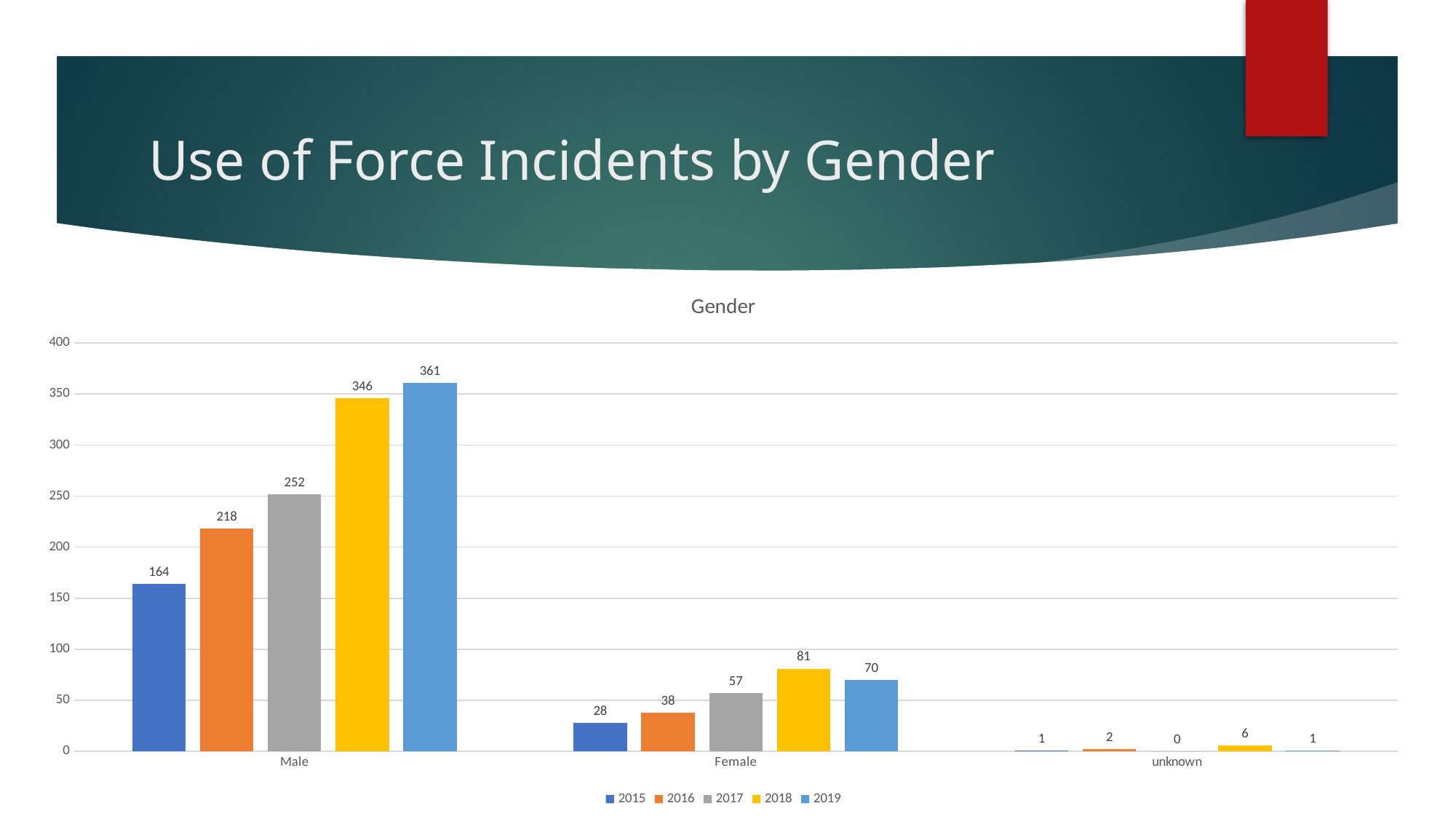
How many series does the legend list? 5 How many categories are shown on the x axis? 3 What is the value for Male in 2019? 361 What is the value for unknown in 2018? 6 Which is larger, the Female value for 2018 or for 2019? 2018 What kind of chart is shown on the slide? bar chart What is the difference between the Male values for 2019 and 2015? 197 Is the value for Male in 2017 greater or less than 200? greater Which year has the lowest value for Female? 2015 Which year has the highest value for Male? 2019 What is the title of the chart? Gender What is the value for Female in 2017? 57